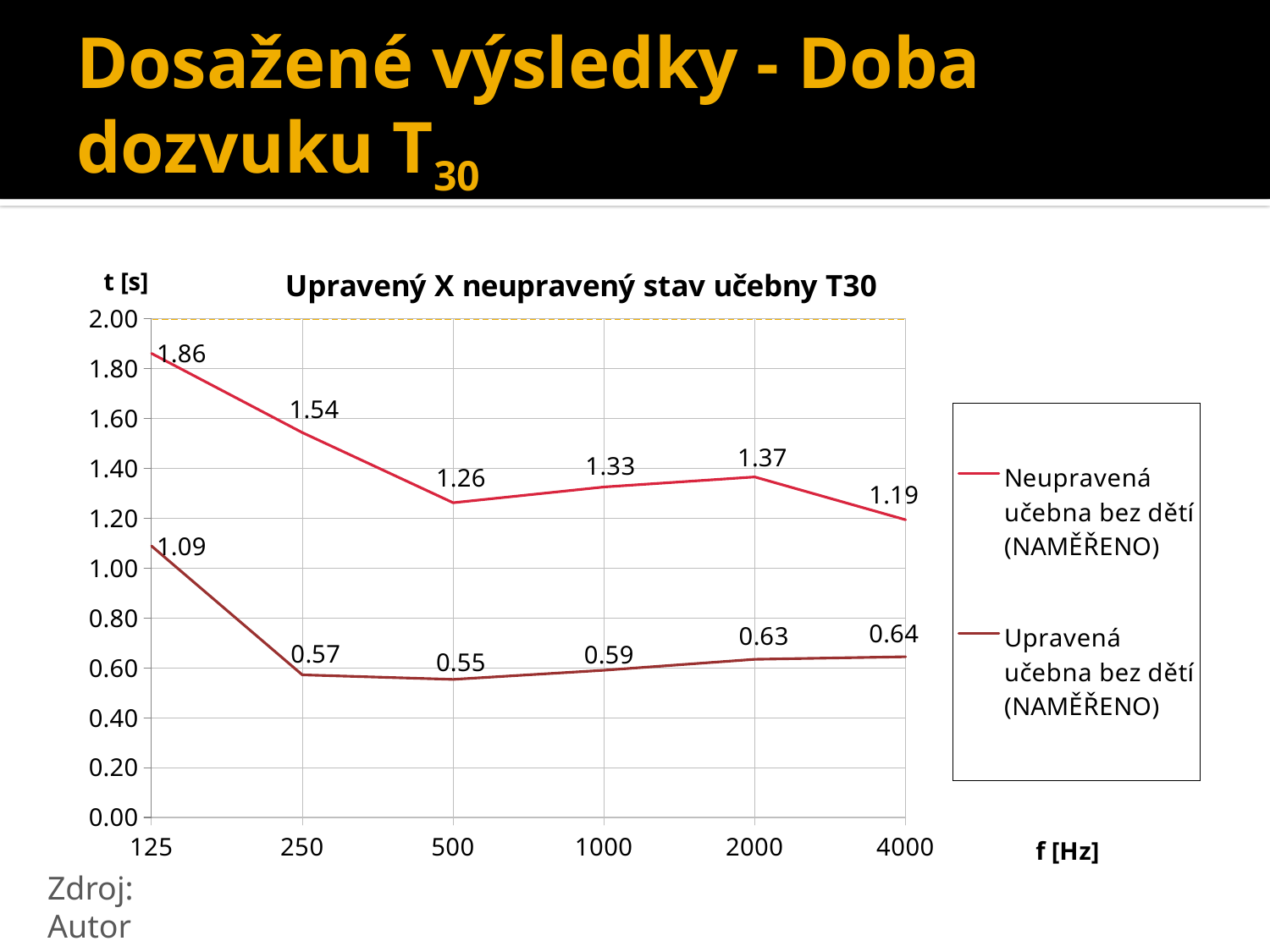
What kind of chart is shown? line chart How many series does the legend list? 2 What is the value of the 'Neupravená učebna bez dětí (NAMĚŘENO)' series at 125 Hz? 1.86 What is the value of the 'Upravená učebna bez dětí (NAMĚŘENO)' series at 500 Hz? 0.55 How many frequency points are plotted on the x axis? 6 What is the value of the 'Neupravená učebna bez dětí (NAMĚŘENO)' series at 2000 Hz? 1.37 What is the difference between the two series at 125 Hz? 0.77 At which frequency is the 'Upravená učebna bez dětí (NAMĚŘENO)' series lowest? 500 At which frequency is the 'Neupravená učebna bez dětí (NAMĚŘENO)' series highest? 125 What is the difference between the two series at 4000 Hz? 0.55 Which series has the larger value at 1000 Hz? Neupravená učebna bez dětí (NAMĚŘENO) What is the title of the chart? Upravený X neupravený stav učebny T30